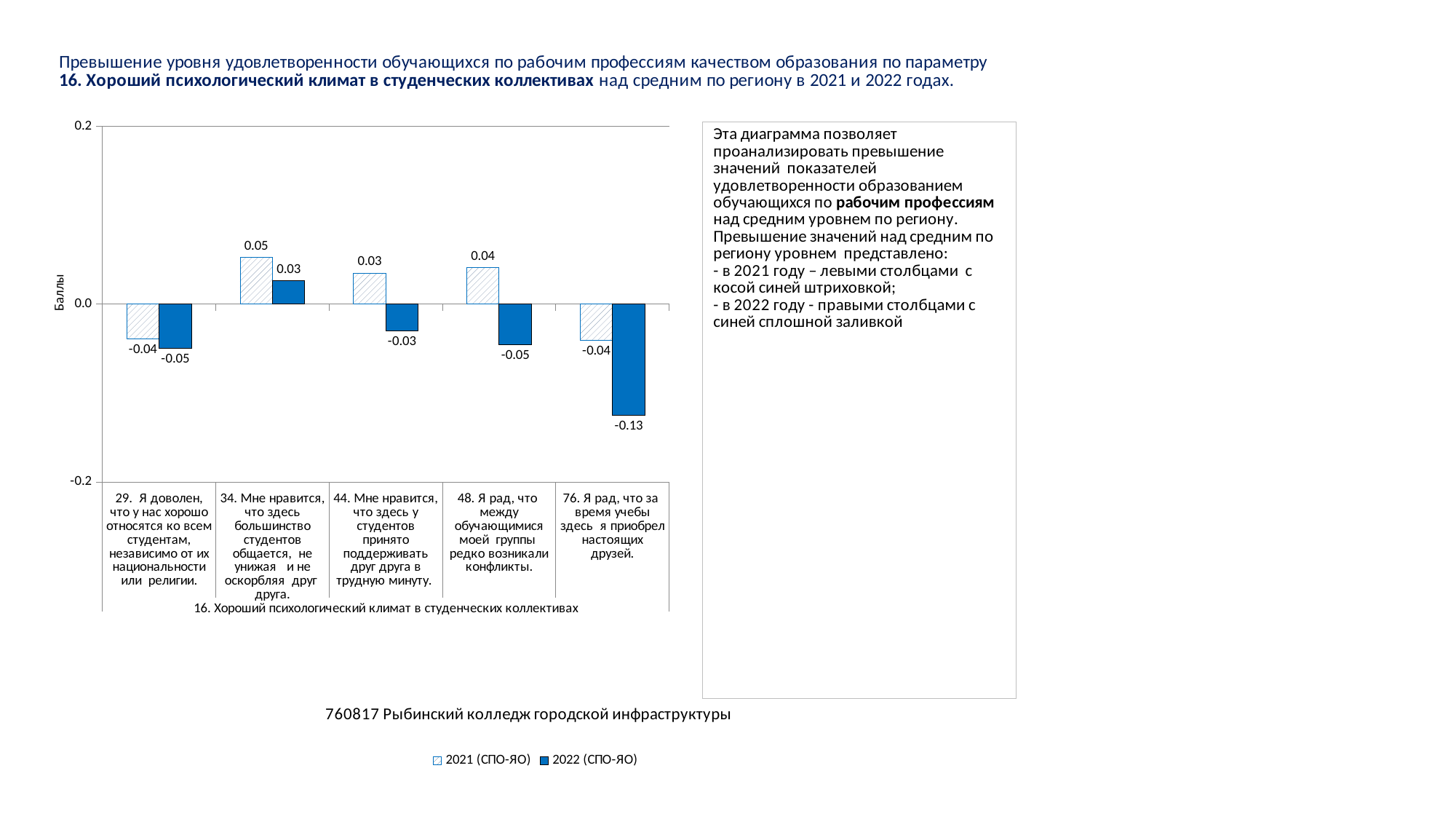
What is the 2022 (СПО-ЯО) value for category 44 ("Мне нравится, что здесь у студентов принято поддерживать друг друга в трудную минуту")? -0.03 How many categories are shown on the x axis of the chart? 5 What is the difference between the 2021 and 2022 values for category 48 ("Я рад, что между обучающимися моей группы редко возникали конфликты")? 0.09 What type of chart is shown on the slide? Bar chart What is the 2022 (СПО-ЯО) value for category 76 ("Я рад, что за время учебы здесь я приобрел настоящих друзей")? -0.13 Which category has the highest 2021 (СПО-ЯО) value? 34. Мне нравится, что здесь большинство студентов общается, не унижая и не оскорбляя друг друга. What is the 2021 (СПО-ЯО) value for category 48 ("Я рад, что между обучающимися моей группы редко возникали конфликты")? 0.04 What is the label of the vertical axis of the chart? Баллы How many series does the chart legend list? 2 What is the 2021 (СПО-ЯО) value for category 34 ("Мне нравится, что здесь большинство студентов общается, не унижая и не оскорбляя друг друга")? 0.05 Which category has the lowest 2022 (СПО-ЯО) value? 76. Я рад, что за время учебы здесь я приобрел настоящих друзей. For category 34, which series has the larger value, 2021 (СПО-ЯО) or 2022 (СПО-ЯО)? 2021 (СПО-ЯО)